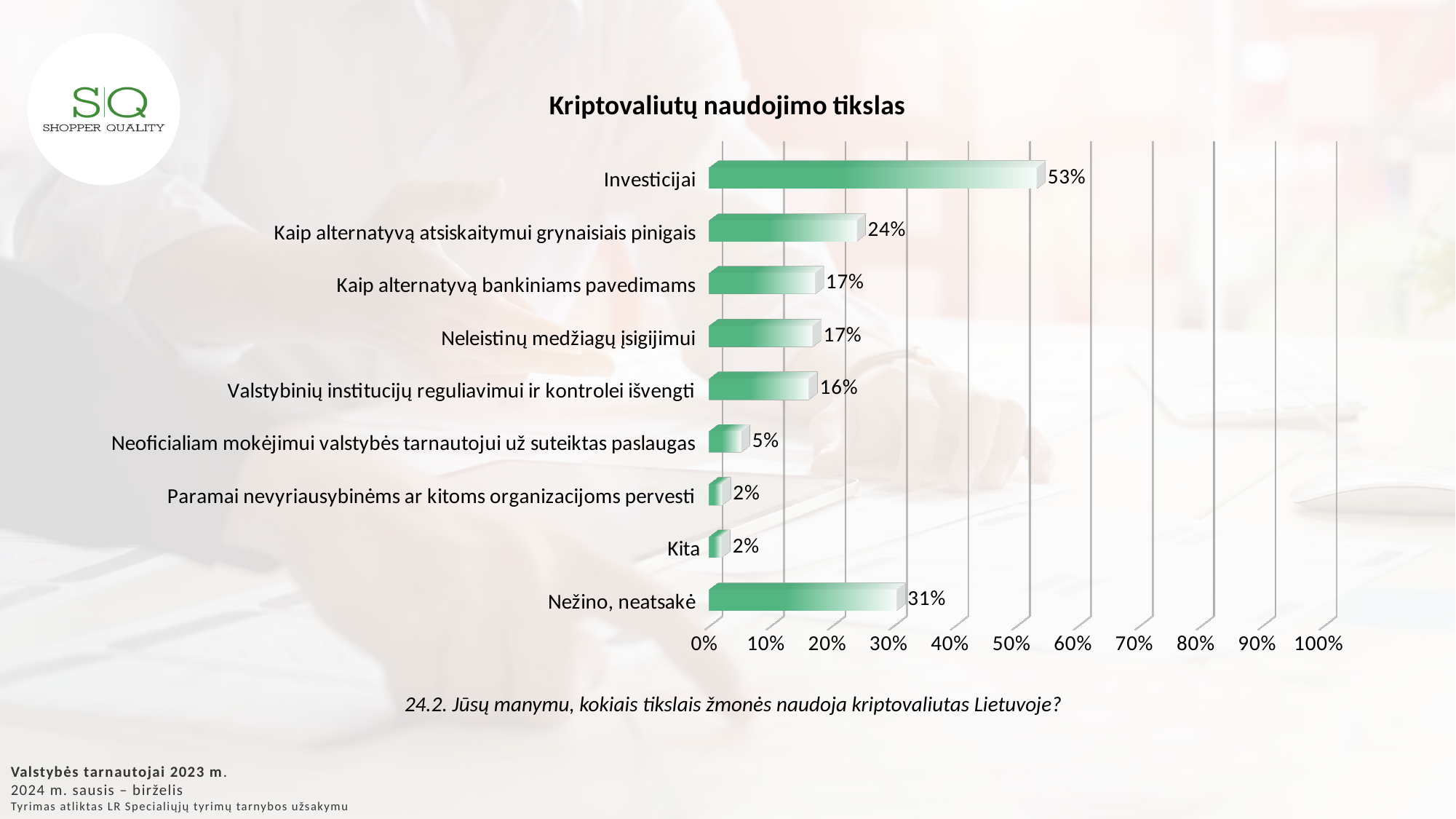
What is the difference between the values for Investicijai and Nežino, neatsakė? 22% Which is larger: the value for Kaip alternatyvą atsiskaitymui grynaisiais pinigais or the value for Valstybinių institucijų reguliavimui ir kontrolei išvengti? Kaip alternatyvą atsiskaitymui grynaisiais pinigais What is the value for Nežino, neatsakė? 31% Which category has the highest value? Investicijai What is the value for Investicijai? 53% What is the value for Kita? 2% How many categories are shown in the chart? 9 What is the title of the chart? Kriptovaliutų naudojimo tikslas What is the value for Kaip alternatyvą atsiskaitymui grynaisiais pinigais? 24% What is the value for Neoficialiam mokėjimui valstybės tarnautojui už suteiktas paslaugas? 5% What kind of chart is shown on the slide? bar chart Is the value for Investicijai greater or less than 50%? greater